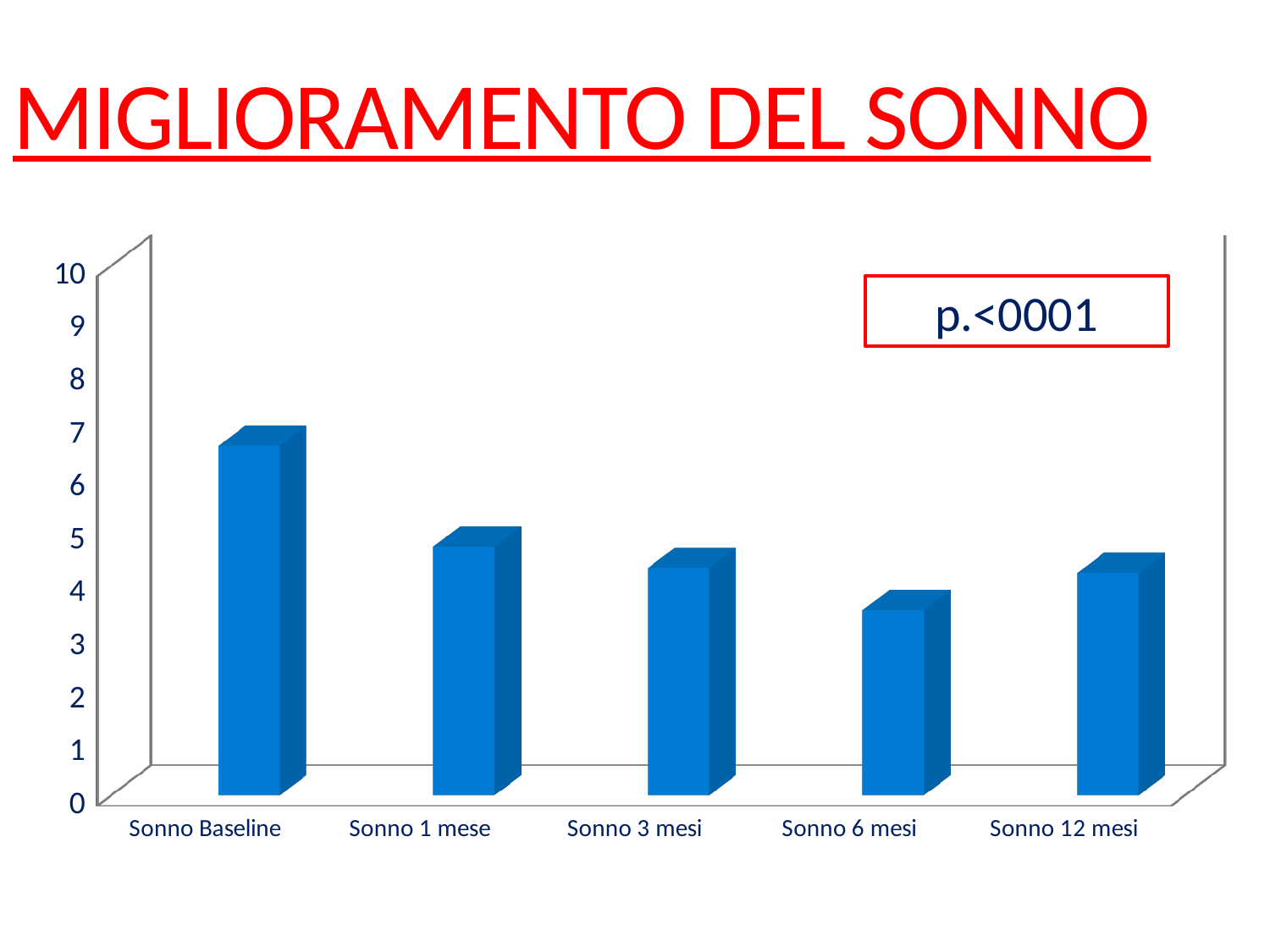
Which is larger, the value for Sonno 6 mesi or for Sonno 12 mesi? Sonno 12 mesi Which is larger, the value for Sonno Baseline or for Sonno 1 mese? Sonno Baseline Is the value for Sonno 12 mesi greater or less than 5? less How many categories are plotted on the x axis? 5 Which category has the lowest value? Sonno 6 mesi Do the values rise or fall from Sonno Baseline to Sonno 6 mesi? fall What kind of chart is shown on the slide? Bar chart What p-value is shown in the box on the chart? p.<0001 Which category has the highest value? Sonno Baseline Is the value for Sonno 1 mese greater or less than 4? greater Is the value for Sonno Baseline greater or less than 6? greater